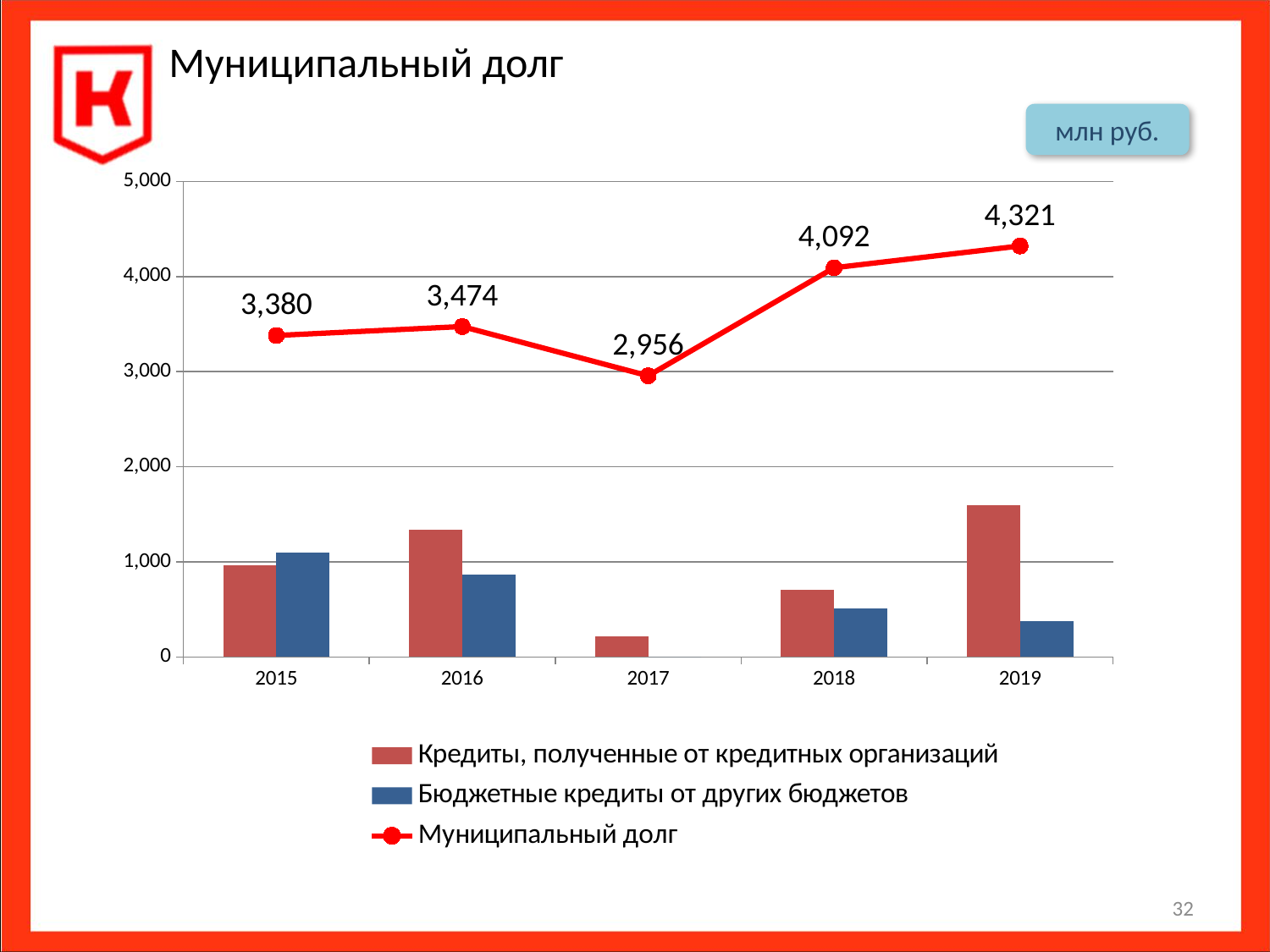
In which year is Муниципальный долг the highest? 2019 Which year has the larger Муниципальный долг, 2015 or 2016? 2016 How many series does the legend list? 3 How many years are shown on the x axis of the chart? 5 In which year is Муниципальный долг the lowest? 2017 Is the value for Кредиты, полученные от кредитных организаций in 2019 greater or less than 1,000? greater Is the value for Бюджетные кредиты от других бюджетов in 2019 greater or less than 1,000? less Does Муниципальный долг rise or fall from 2017 to 2019? rise What is the difference in Муниципальный долг between 2016 and 2015? 94 By how much did Муниципальный долг increase from 2018 to 2019? 229 What is the value of Муниципальный долг in 2017? 2,956 What is the value of Муниципальный долг in 2019? 4,321